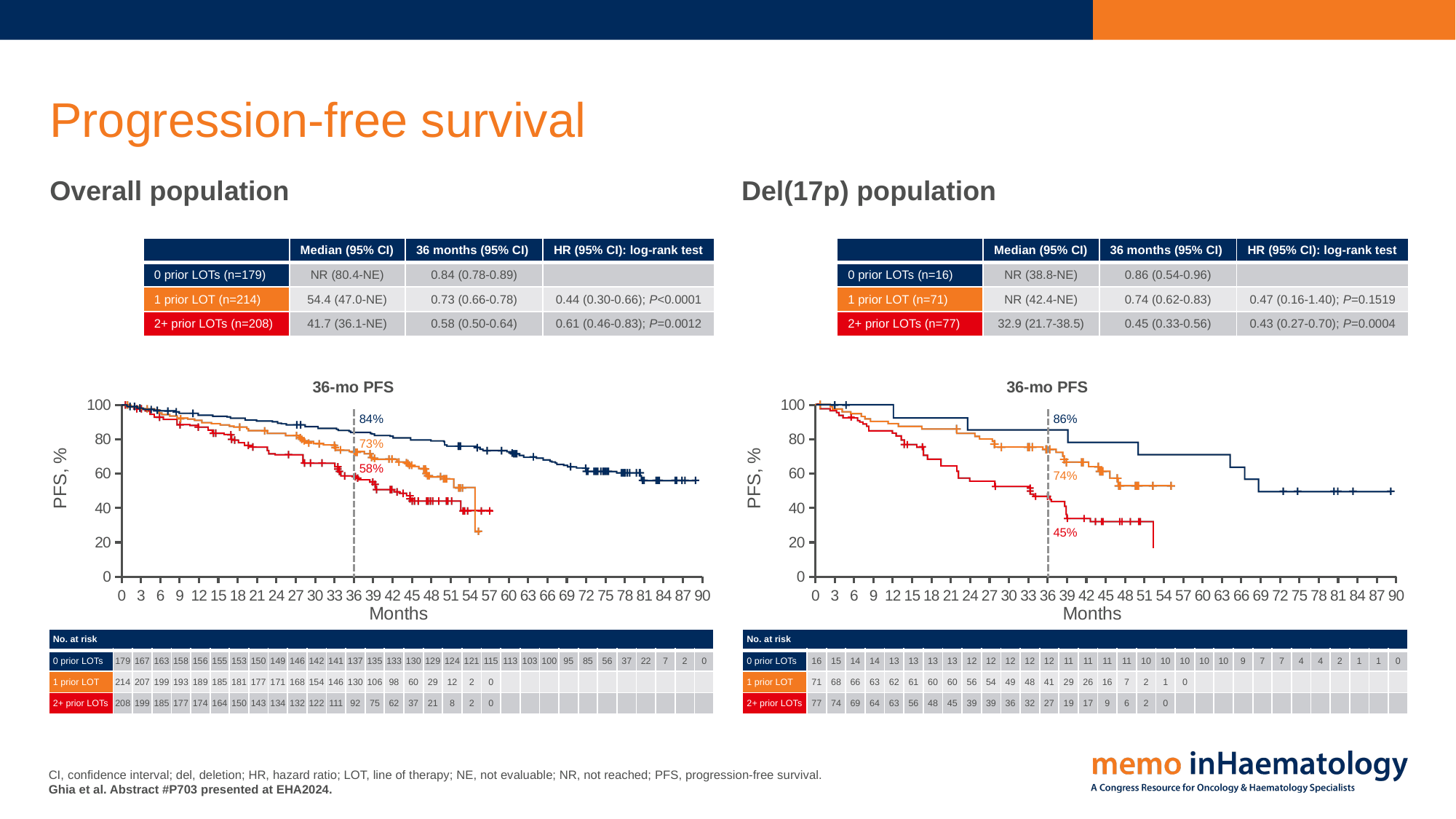
In the Overall population chart, what is the 36-month PFS for the 0 prior LOTs group? 84% In the Del(17p) population chart, what is the difference in 36-month PFS between the 0 prior LOTs and 2+ prior LOTs groups? 41 percentage points What kind of chart is used to show PFS in the Overall population panel? Line chart (Kaplan-Meier survival curve) In the Del(17p) population chart, which group has the lowest 36-month PFS? 2+ prior LOTs In the Overall population chart, what is the 36-month PFS for the 2+ prior LOTs group? 58% In the Del(17p) population chart, what is the 36-month PFS for the 2+ prior LOTs group? 45% In the Overall population chart, what is the difference in 36-month PFS between the 0 prior LOTs and 2+ prior LOTs groups? 26 percentage points In the Del(17p) population chart, what is the 36-month PFS for the 1 prior LOT group? 74% Is the 36-month PFS for the 2+ prior LOTs group higher in the Overall population chart or the Del(17p) population chart? Overall population In the Overall population chart, which group has the highest 36-month PFS? 0 prior LOTs In the Del(17p) population chart, do the PFS curves rise or fall as months increase? Fall In the Overall population chart's number-at-risk table, how many patients in the 1 prior LOT group are at risk at 0 months? 214